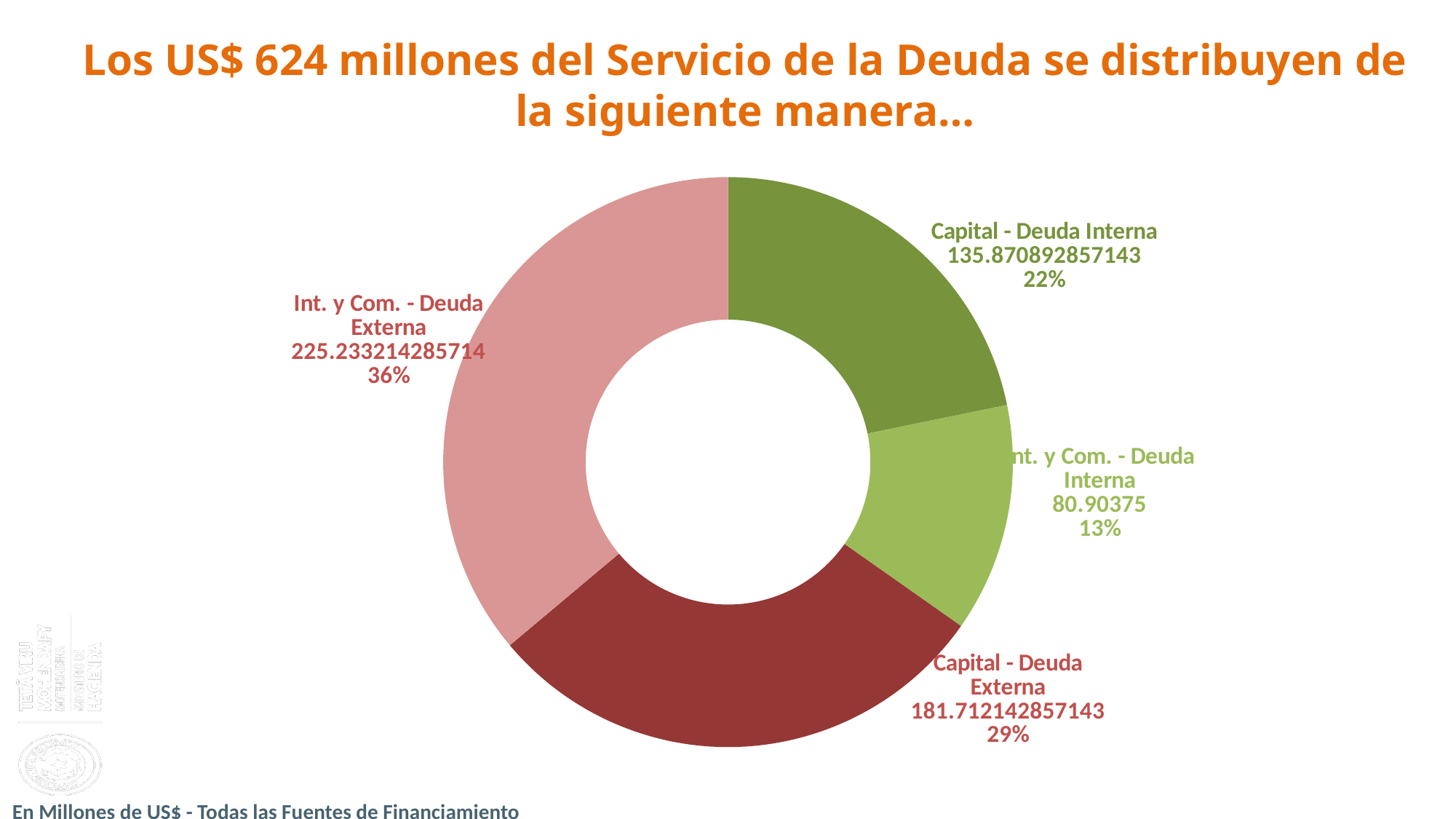
Which category has the largest share of the chart? Int. y Com. - Deuda Externa What is the value for Capital - Deuda Interna? 135.870892857143 What is the value for Int. y Com. - Deuda Externa? 225.233214285714 What kind of chart is shown on the slide? Doughnut (pie) chart What is the title of the chart on the slide? Los US$ 624 millones del Servicio de la Deuda se distribuyen de la siguiente manera... What percentage share does Capital - Deuda Interna have? 22% Which category has the smallest share of the chart? Int. y Com. - Deuda Interna Which is larger, the value for Capital - Deuda Externa or the value for Capital - Deuda Interna? Capital - Deuda Externa How many categories does the chart show? 4 What is the value for Capital - Deuda Externa? 181.712142857143 What percentage share does Capital - Deuda Externa have? 29% What is the value for Int. y Com. - Deuda Interna? 80.90375